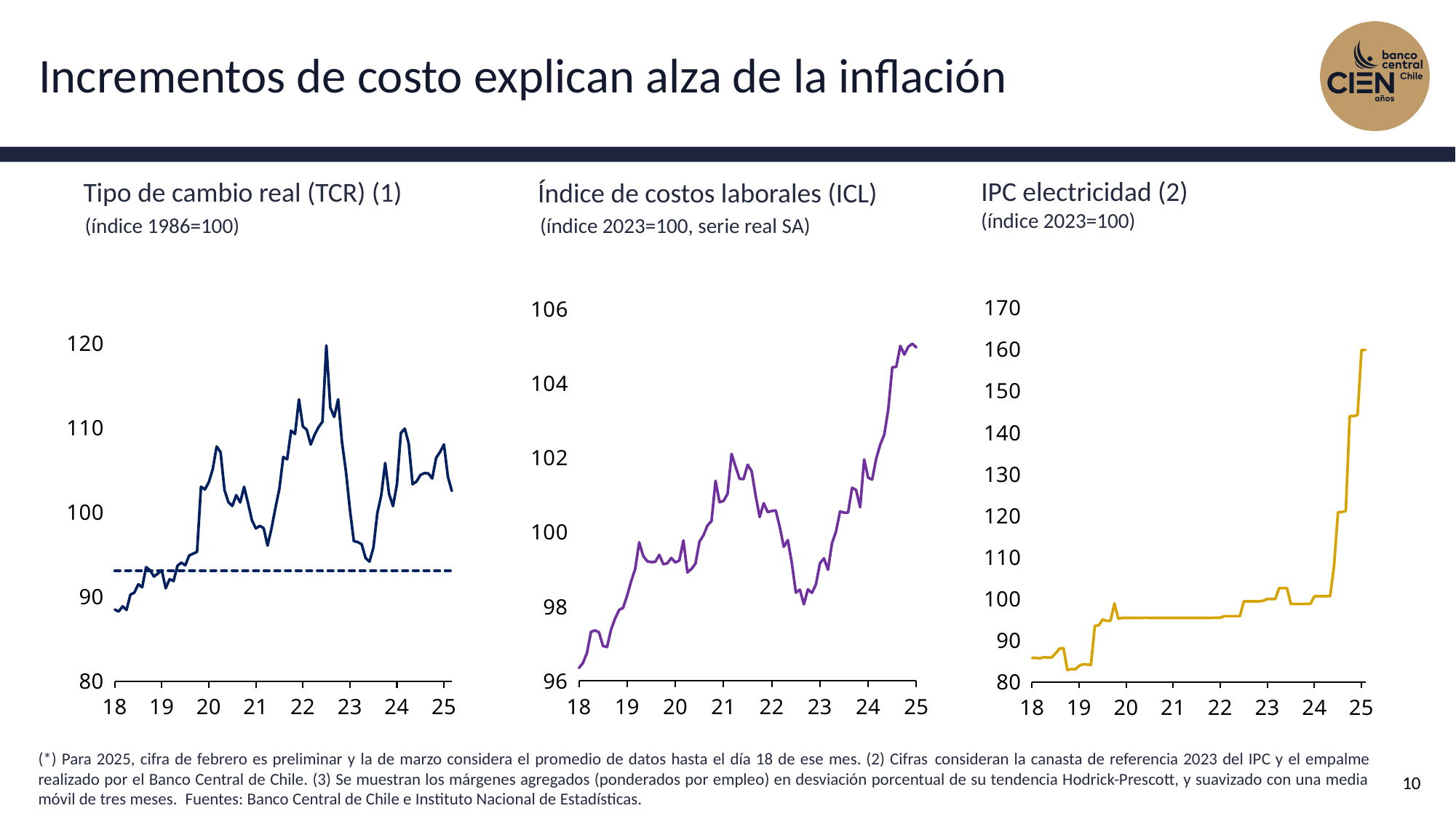
In the 'IPC electricidad (2)' chart, which is larger: the value at 25 or the value at 18? 25 In the 'Tipo de cambio real (TCR) (1)' chart, is the peak value reached around 22 greater or less than 110? greater In the 'Índice de costos laborales (ICL)' chart, is the value at 25 greater or less than 104? greater What is the highest value shown on the y axis of the 'IPC electricidad (2)' chart? 170 In the 'IPC electricidad (2)' chart, is the value at 25 greater or less than 150? greater In the 'IPC electricidad (2)' chart, does the series rise or fall overall from 18 to 25? rise What kind of chart is the 'Tipo de cambio real (TCR) (1)' chart? line chart How many charts are shown on the slide? 3 In the 'Índice de costos laborales (ICL)' chart, does the series rise or fall from 23 to 25? rise